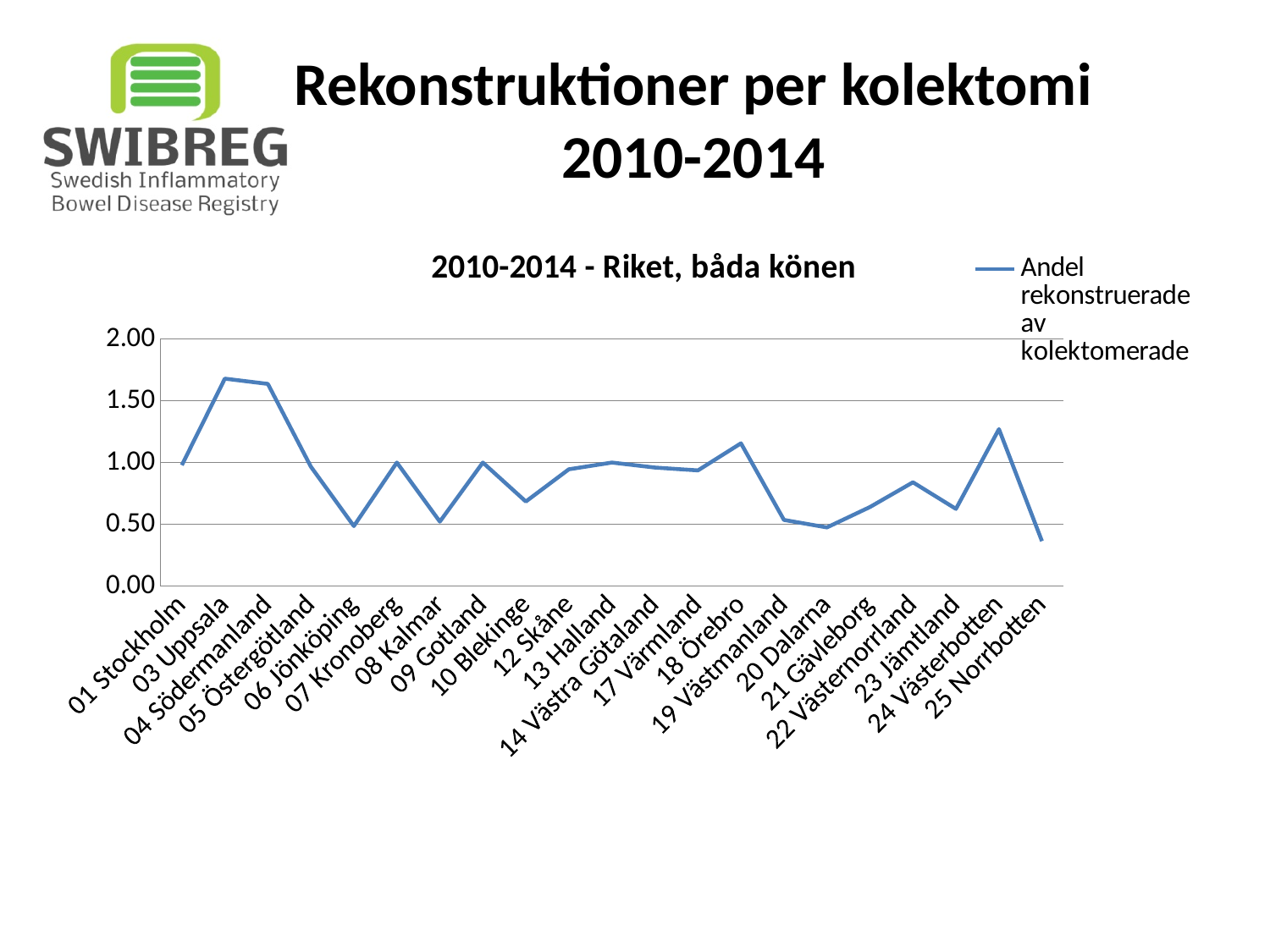
How many series does the legend list? 1 Which region has the lowest value? 25 Norrbotten Is the value for 25 Norrbotten greater or less than 0.50? less Which has a higher value, 24 Västerbotten or 23 Jämtland? 24 Västerbotten Is the value for 03 Uppsala greater or less than 1.50? greater How many regions are plotted along the x axis? 21 Is the value for 10 Blekinge greater or less than 1.00? less What is the name of the series shown in the legend? Andel rekonstruerade av kolektomerade What kind of chart is shown on the slide? line chart Which has a higher value, 03 Uppsala or 01 Stockholm? 03 Uppsala What is the title of the chart? 2010-2014 - Riket, båda könen